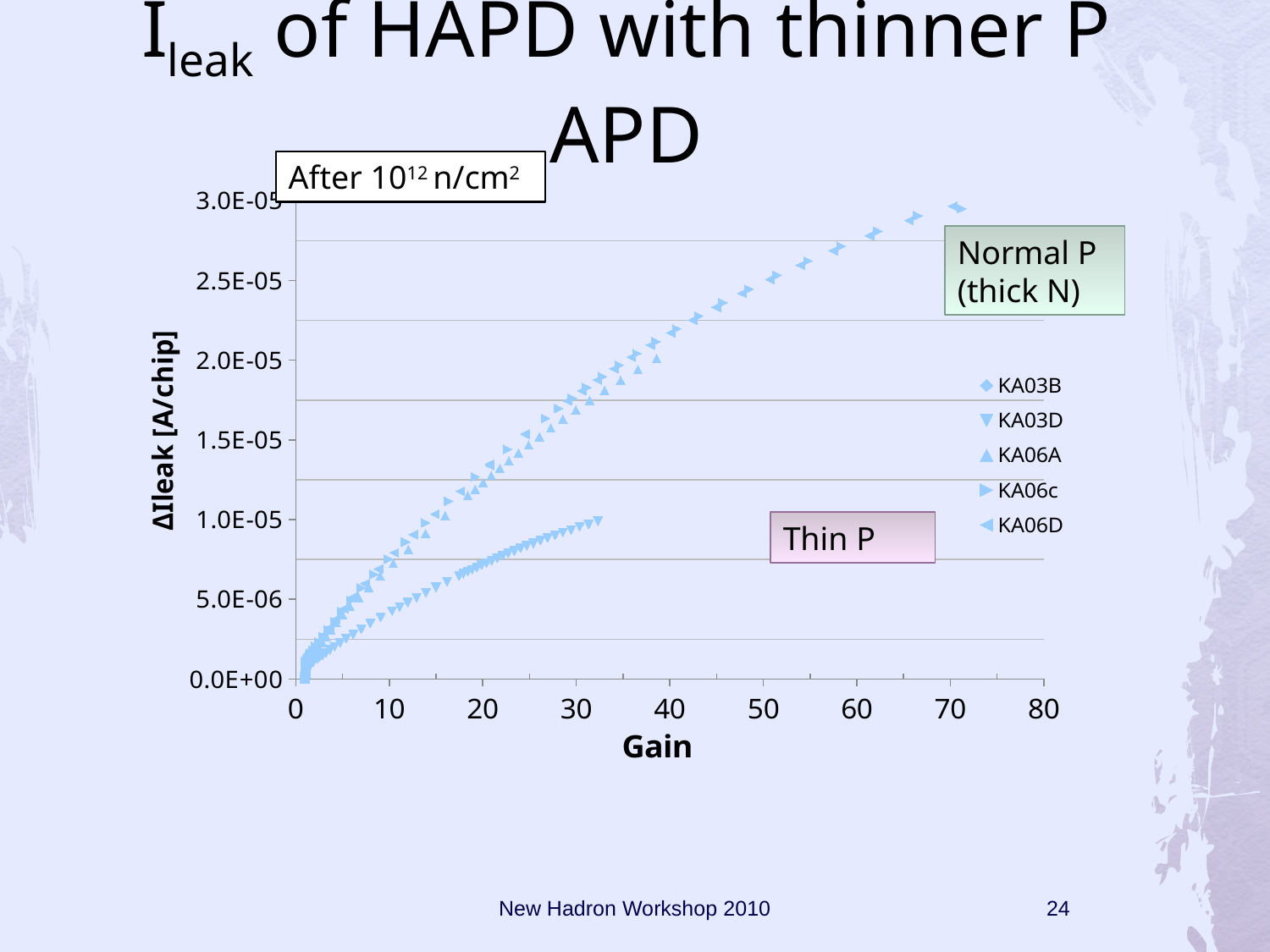
What kind of chart is shown on the slide? scatter chart Is the value for KA03D at a gain of about 20 greater or less than 1.0E-05? less What is the highest tick value shown on the y axis? 3.0E-05 Is the value for KA03B at a gain of about 70 greater or less than 2.5E-05? greater What is the label of the y axis? ΔIleak [A/chip] Does ΔIleak rise or fall as Gain increases? rise Is the value for KA06A at a gain of about 40 greater or less than 1.5E-05? greater What is the label of the x axis? Gain Which series extends to the highest gain on the x axis? KA03B At a gain of about 30, which series has the larger ΔIleak, KA03D or KA06A? KA06A Which series reaches the lowest maximum ΔIleak? KA03D How many series does the legend list? 5